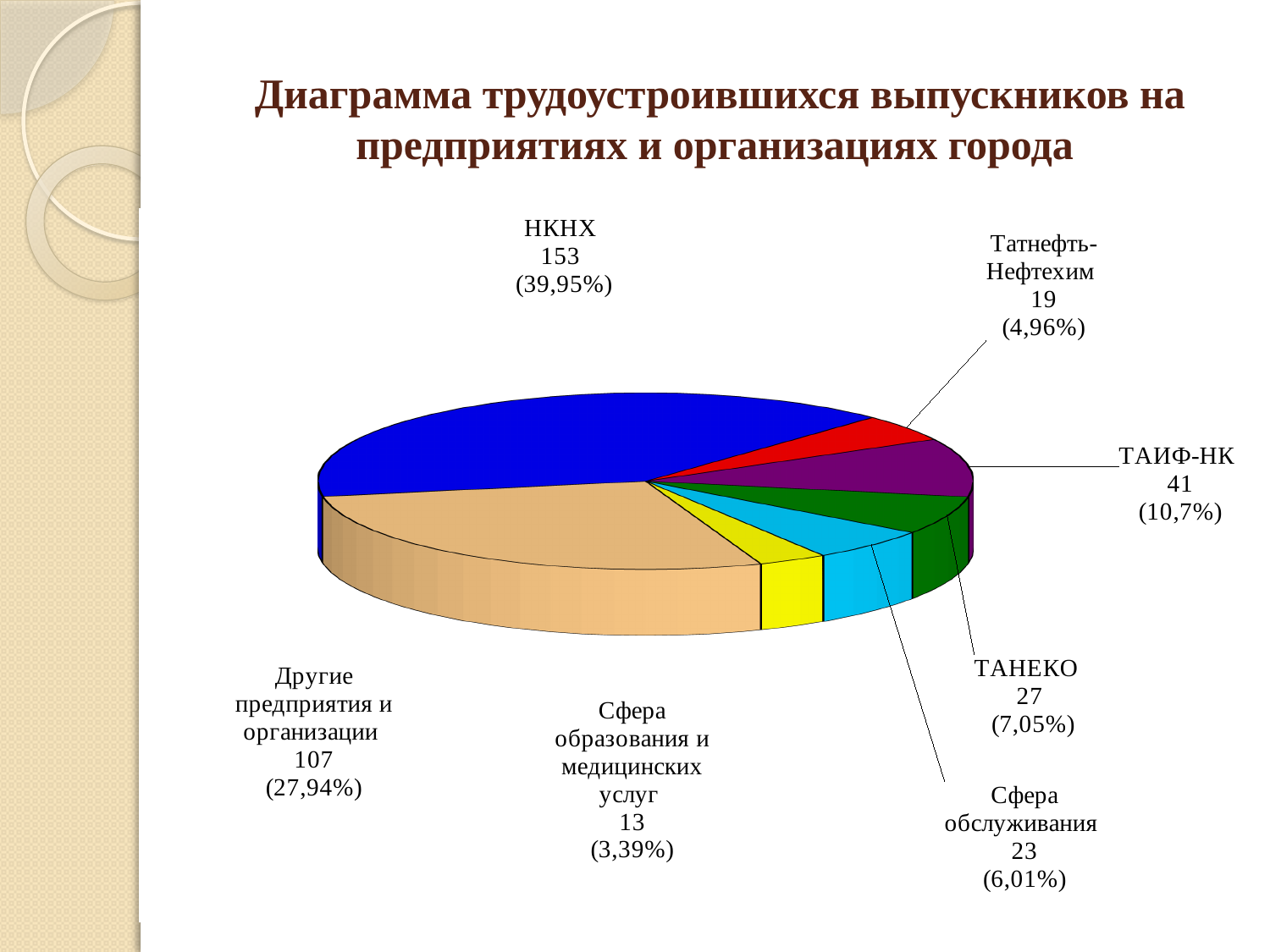
What share of the pie does ТАНЕКО represent? 7,05% Which category has the smallest slice? Сфера образования и медицинских услуг What is the value for Сфера обслуживания? 23 What kind of chart is shown on the slide? Pie chart What share of the pie does Другие предприятия и организации represent? 27,94% What is the title of the chart? Диаграмма трудоустроившихся выпускников на предприятиях и организациях города How many slices does the pie chart have? 7 Which is larger, the value for ТАИФ-НК or the value for ТАНЕКО? ТАИФ-НК What is the difference between the values for НКНХ and Другие предприятия и организации? 46 What is the value for НКНХ? 153 What is the value for ТАИФ-НК? 41 Which category has the largest slice? НКНХ